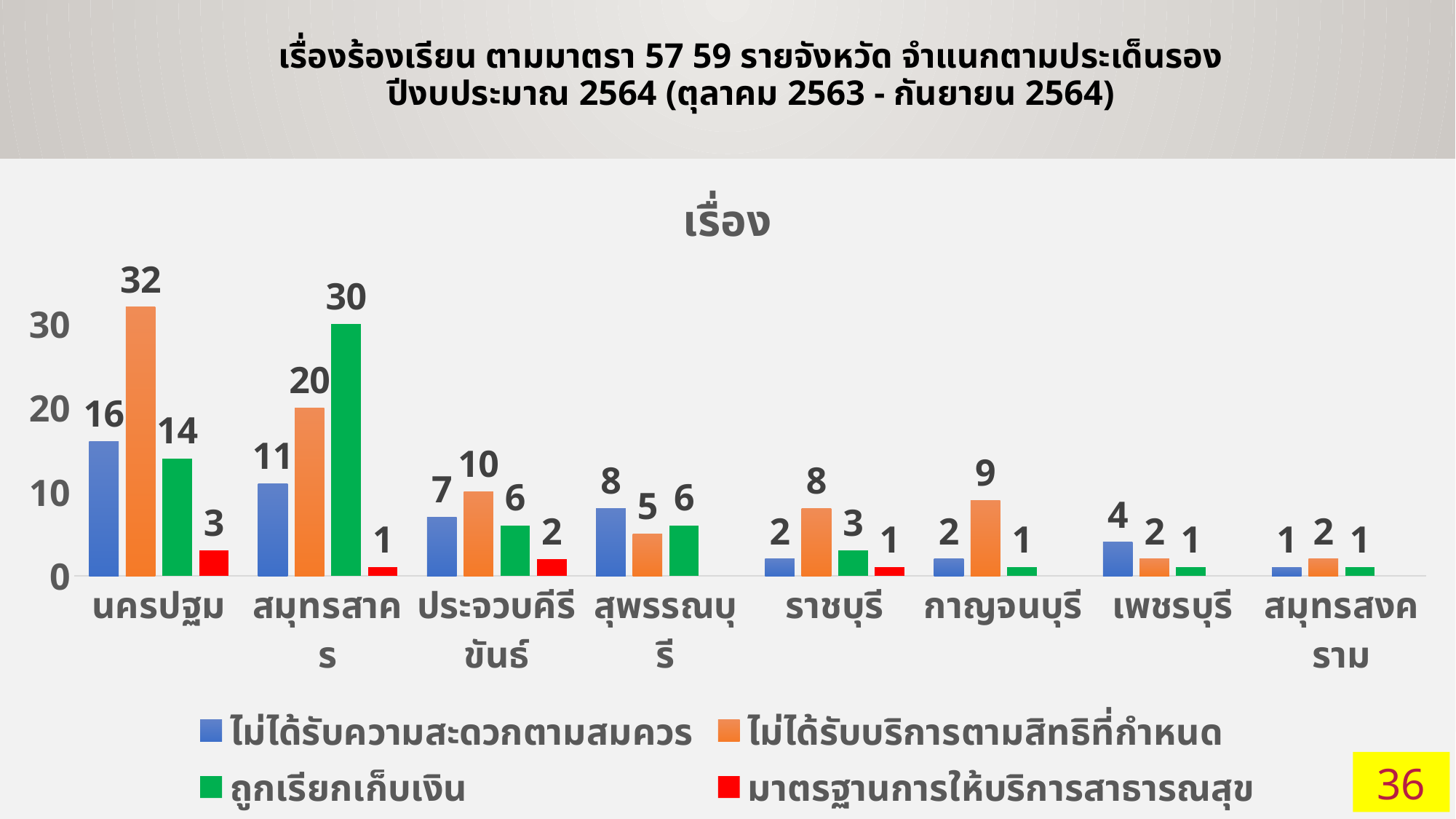
How many provinces (categories) are shown on the x axis? 8 Which is larger for กาญจนบุรี: ไม่ได้รับบริการตามสิทธิที่กำหนด or ไม่ได้รับความสะดวกตามสมควร? ไม่ได้รับบริการตามสิทธิที่กำหนด What is the value of มาตรฐานการให้บริการสาธารณสุข for ประจวบคีรีขันธ์? 2 Which province has the lowest value for ไม่ได้รับบริการตามสิทธิที่กำหนด? เพชรบุรี and สมุทรสงคราม (both 2) What is the value of ไม่ได้รับความสะดวกตามสมควร for สุพรรณบุรี? 8 What is the value of ไม่ได้รับบริการตามสิทธิที่กำหนด for นครปฐม? 32 Which province has the highest value for ไม่ได้รับความสะดวกตามสมควร? นครปฐม How many series does the legend list? 4 What is the value of ถูกเรียกเก็บเงิน for สมุทรสาคร? 30 What type of chart is shown on the slide? bar chart What is the difference between ไม่ได้รับบริการตามสิทธิที่กำหนด and ไม่ได้รับความสะดวกตามสมควร for นครปฐม? 16 What colour represents the series ถูกเรียกเก็บเงิน? green